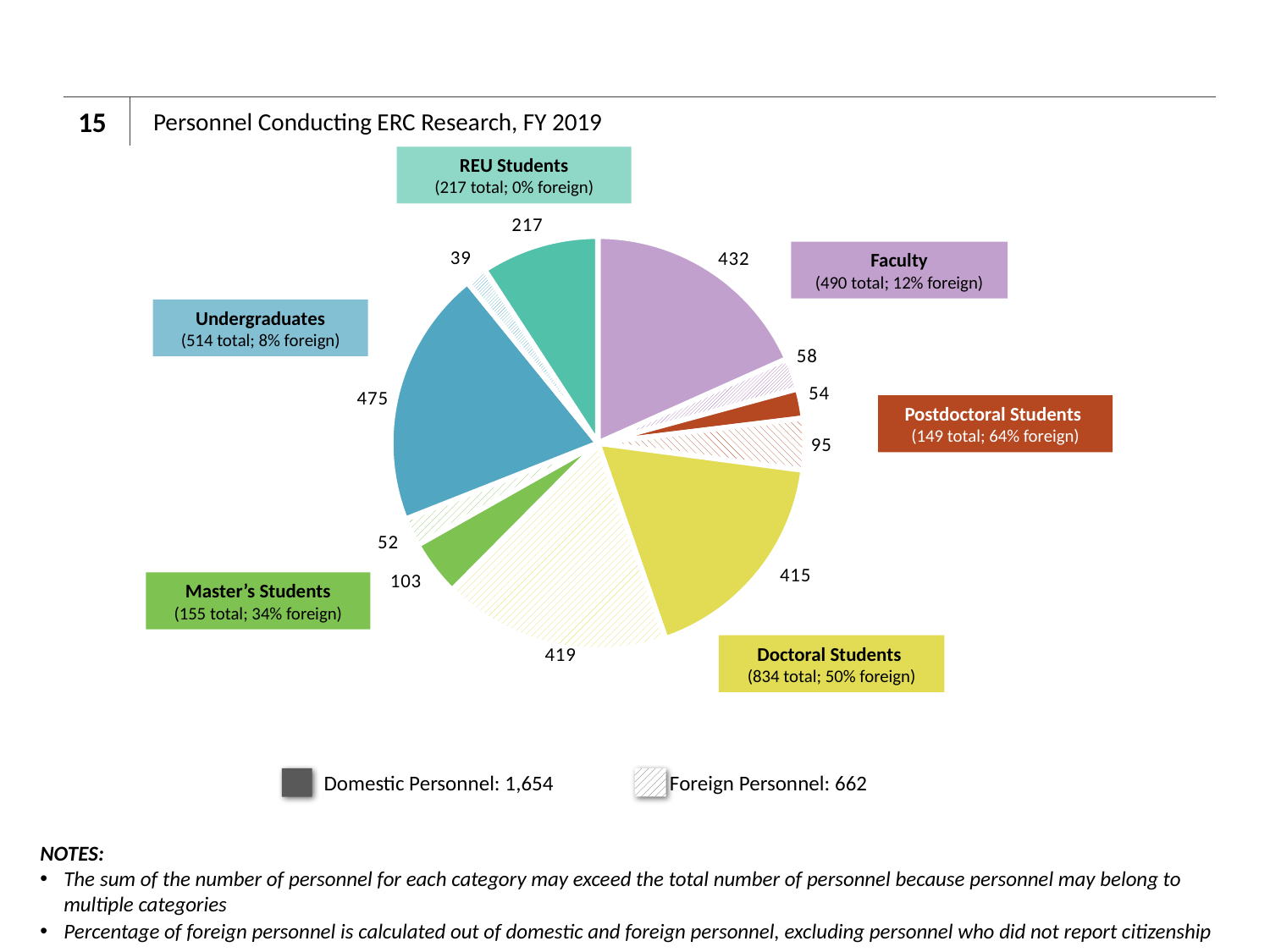
What is the difference between the number of domestic Faculty (432) and foreign Faculty (58)? 374 How many domestic Undergraduates are shown on the pie chart? 475 How many personnel categories are labelled on the pie chart? 6 What percentage of Postdoctoral Students are foreign? 64% How many domestic Faculty personnel are shown on the pie chart? 432 How many foreign Doctoral Students are shown on the pie chart? 419 Which personnel category has the smallest total number of personnel? Postdoctoral Students Which personnel category has the largest total number of personnel? Doctoral Students What is the total number of Doctoral Students according to the label box? 834 Which is larger: the number of domestic Postdoctoral Students or foreign Postdoctoral Students? foreign Postdoctoral Students According to the legend, how many Domestic Personnel are there in total? 1,654 What type of chart is shown on the slide? pie chart